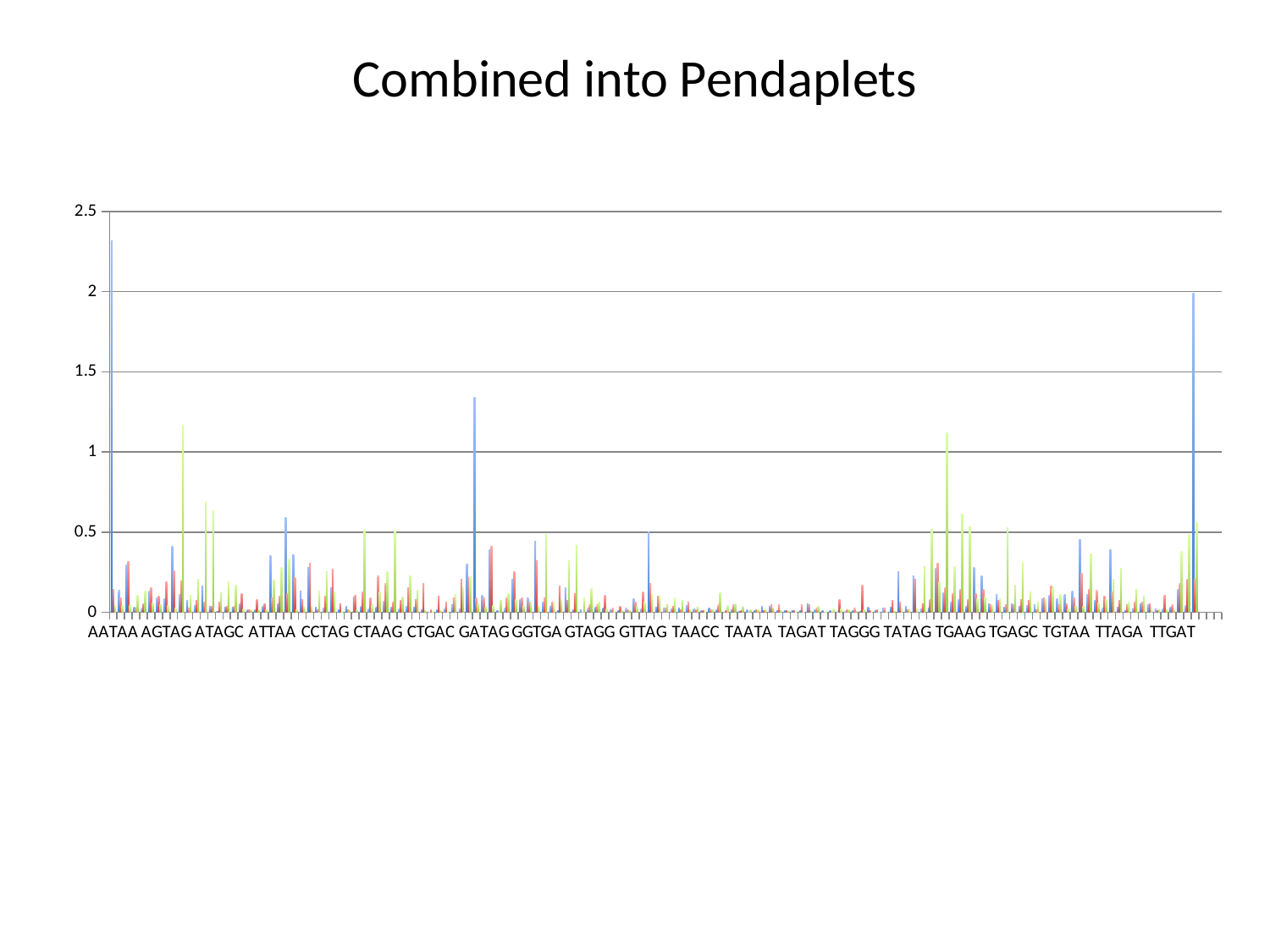
Is the tallest bar near the AATAA label greater or less than 2? greater Is the tallest bar near the AGTAG label greater or less than 1? greater Which x-axis label is closest to the tallest bar in the chart? AATAA How many category labels are printed along the x axis? 21 Which is taller: the tallest bar near AATAA or the tallest bar near TTGAT? the tallest bar near AATAA What kind of chart is shown on the slide? bar chart How many different bar colours are used in the chart? 3 Which is taller: the tallest bar near TAGAT or the tallest bar near GATAG? the tallest bar near GATAG Is the tallest bar near the TAATA label greater or less than 0.5? less What is the title of the chart? Combined into Pendaplets